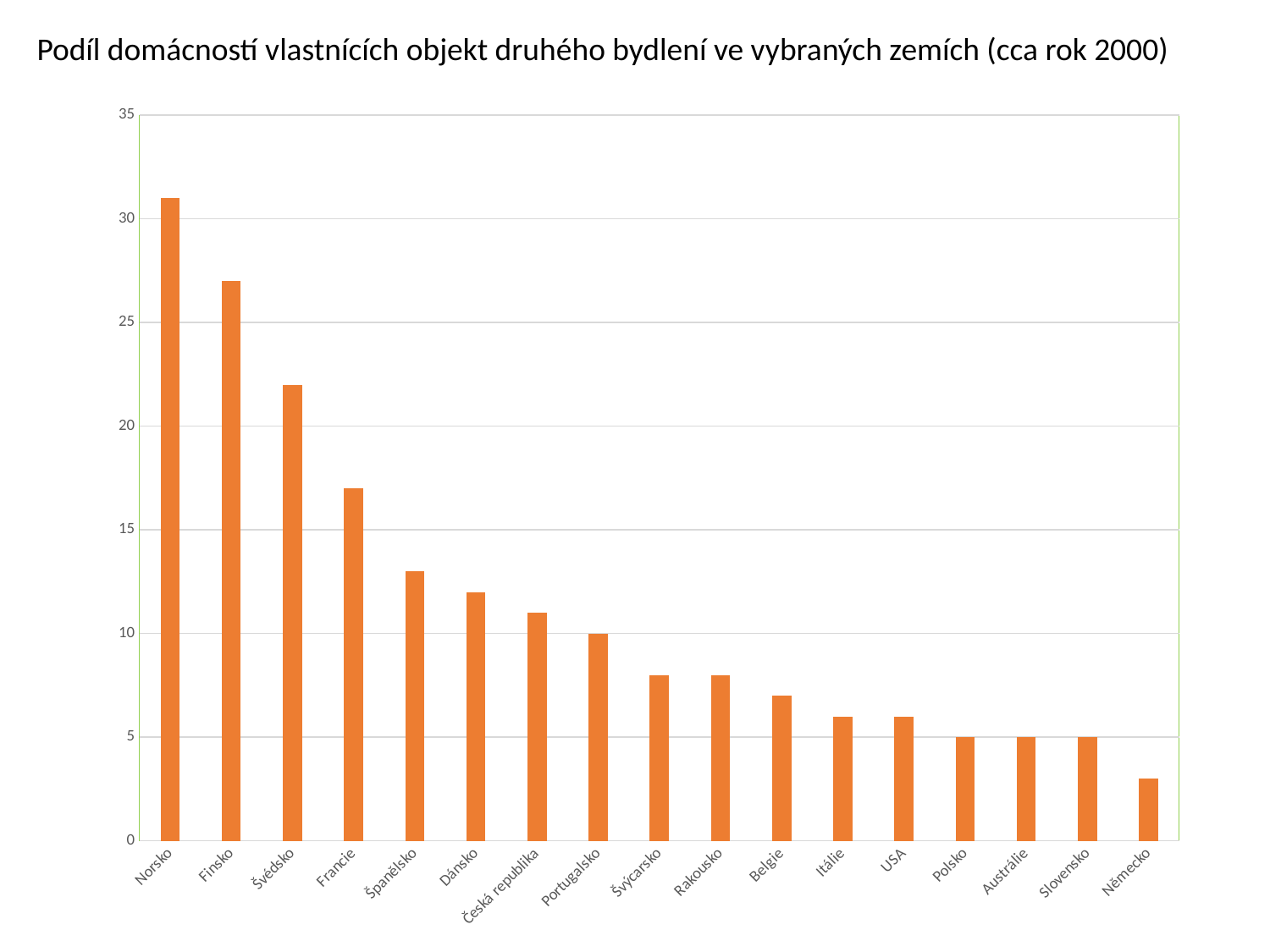
Which is larger, the value for Norsko or the value for Finsko? Norsko How many countries are shown on the x axis? 17 Do the values rise or fall from left to right along the x axis? fall What kind of chart is shown on the slide? bar chart Is the value for Španělsko greater or less than 15? less Which country has the highest value? Norsko Is the value for Francie greater or less than 15? greater Is the value for Norsko greater or less than 30? greater Which country has the lowest value? Německo What is the title of the chart? Podíl domácností vlastnících objekt druhého bydlení ve vybraných zemích (cca rok 2000)